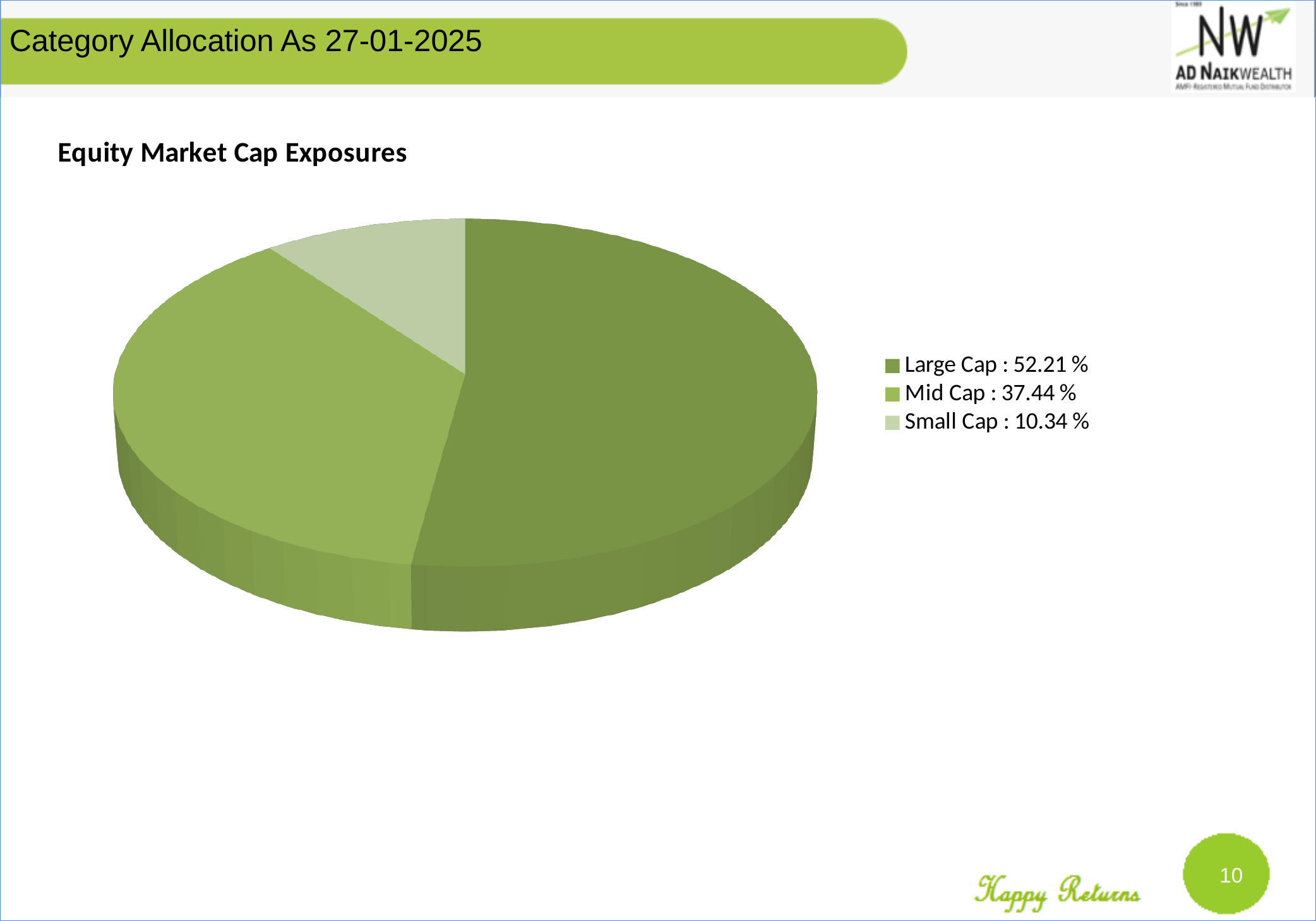
What is the value for Large Cap? 52.21 % How many categories does the pie chart show? 3 What is the value for Small Cap? 10.34 % What is the difference between the Large Cap and Mid Cap values? 14.77 % What kind of chart is shown on the slide? Pie chart Which category has the largest share of the pie? Large Cap Which category has the smallest share of the pie? Small Cap What is the title of the chart? Equity Market Cap Exposures Which is larger, Mid Cap or Small Cap? Mid Cap What is the difference between the Mid Cap and Small Cap values? 27.10 % What is the value for Mid Cap? 37.44 % Which category is shown in the lightest green colour? Small Cap